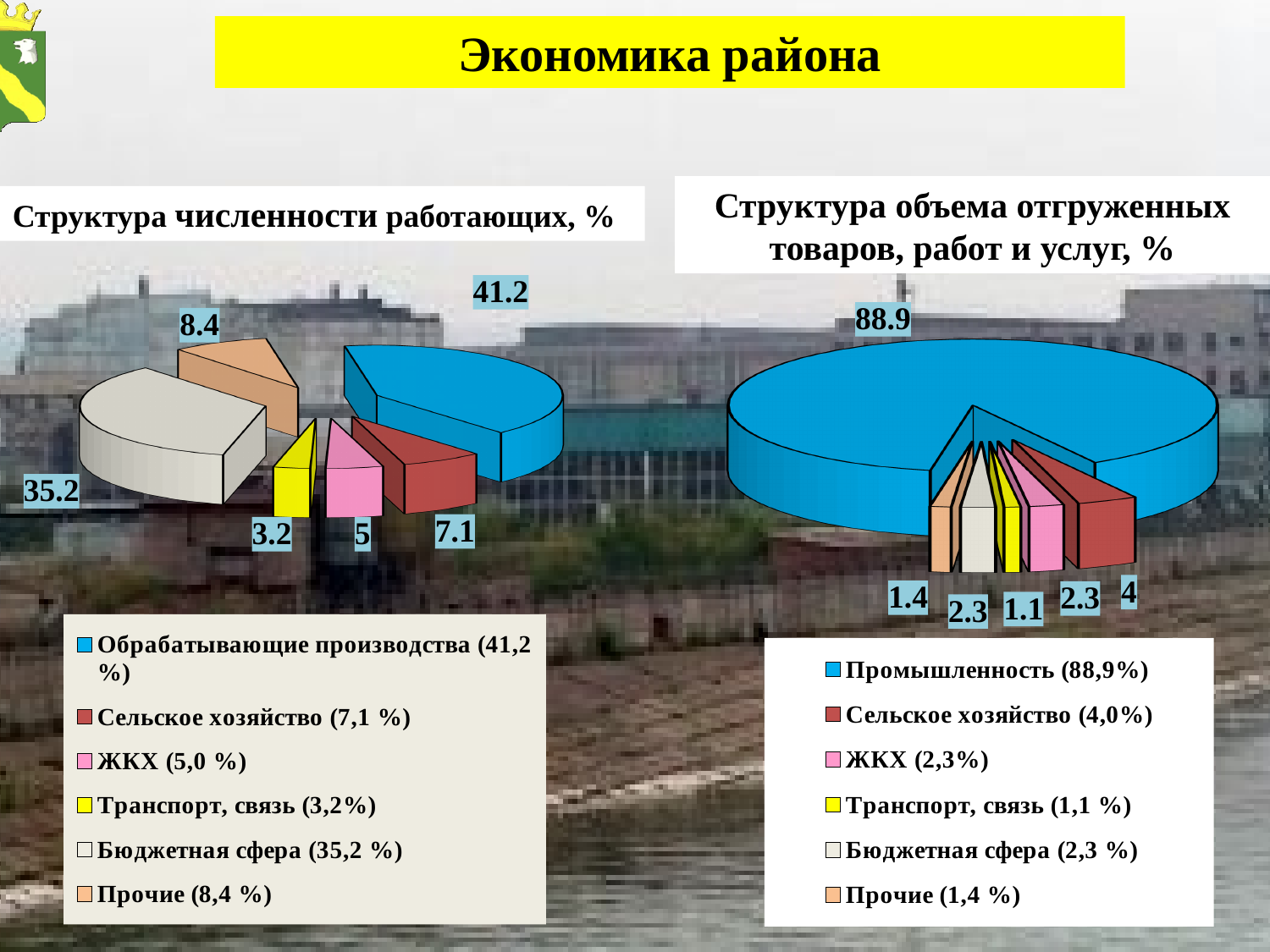
What type of chart is 'Структура численности работающих, %'? Pie chart In the chart 'Структура объема отгруженных товаров, работ и услуг, %', which category has the largest share? Промышленность In the chart 'Структура численности работающих, %', what is the value for Бюджетная сфера? 35.2 In the chart 'Структура объема отгруженных товаров, работ и услуг, %', which category has the smallest share? Транспорт, связь In the chart 'Структура численности работающих, %', what colour is the slice for Транспорт, связь? Yellow In the chart 'Структура численности работающих, %', what is the value for Обрабатывающие производства? 41.2 In the chart 'Структура численности работающих, %', what is the difference between Обрабатывающие производства and Бюджетная сфера? 6 In the chart 'Структура объема отгруженных товаров, работ и услуг, %', what is the value for Промышленность? 88.9 In the chart 'Структура численности работающих, %', which is larger: Сельское хозяйство or ЖКХ? Сельское хозяйство How many categories does the legend of the chart 'Структура объема отгруженных товаров, работ и услуг, %' list? 6 In the chart 'Структура объема отгруженных товаров, работ и услуг, %', what is the difference between Сельское хозяйство and Прочие? 2.6 In the chart 'Структура численности работающих, %', which category has the smallest share? Транспорт, связь